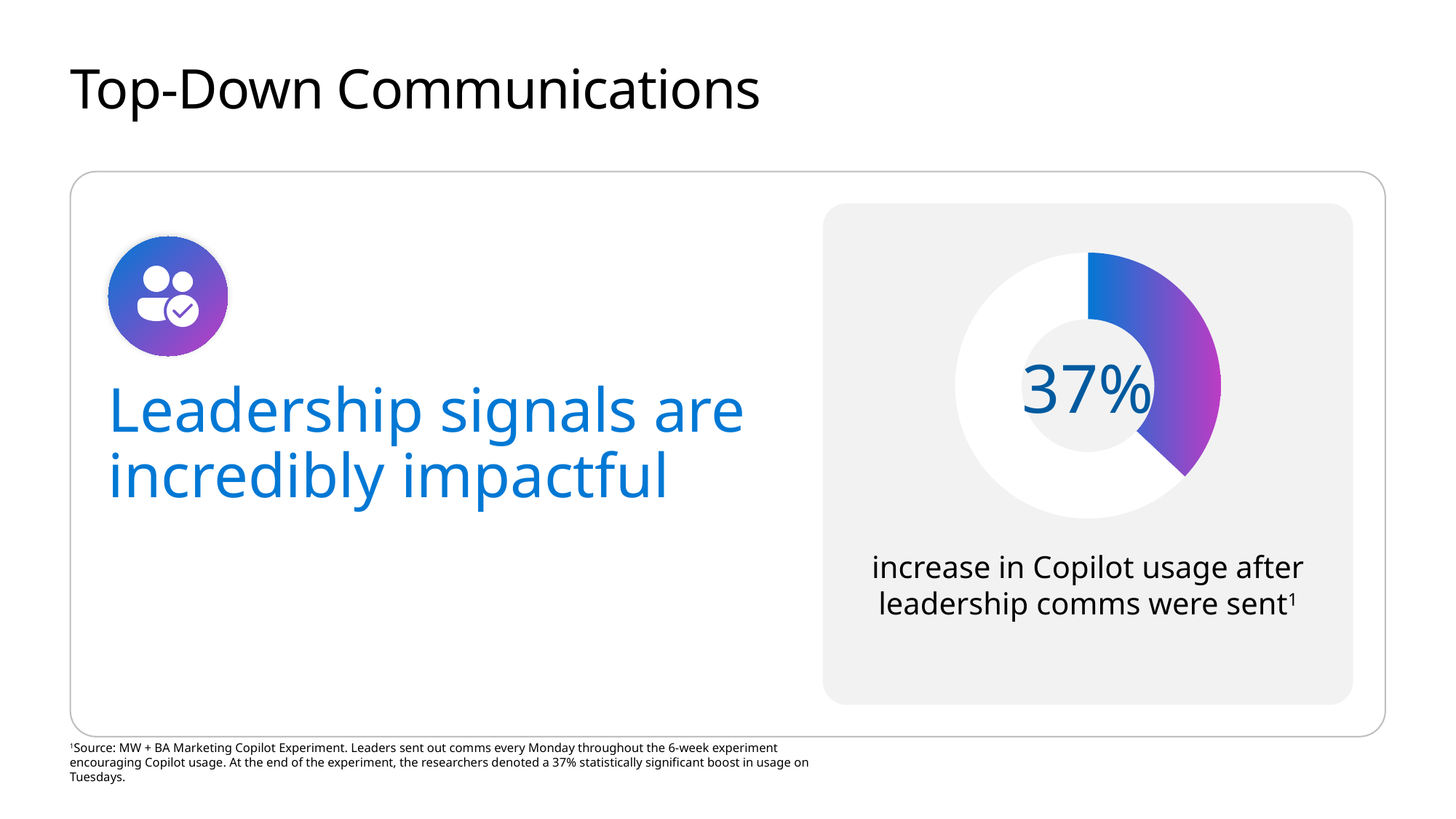
What kind of chart is shown on the slide? Donut (pie) chart What is the title of the slide containing the donut chart? Top-Down Communications What percentage is shown in the centre of the donut chart? 37% According to the chart, what was the increase in Copilot usage after leadership comms were sent? 37% Is the value shown in the donut chart greater or less than 50%? less What does the text below the donut chart say the 37% represents? increase in Copilot usage after leadership comms were sent Is the value shown in the donut chart greater or less than 25%? greater What share of the donut chart is filled with the coloured segment? 37%